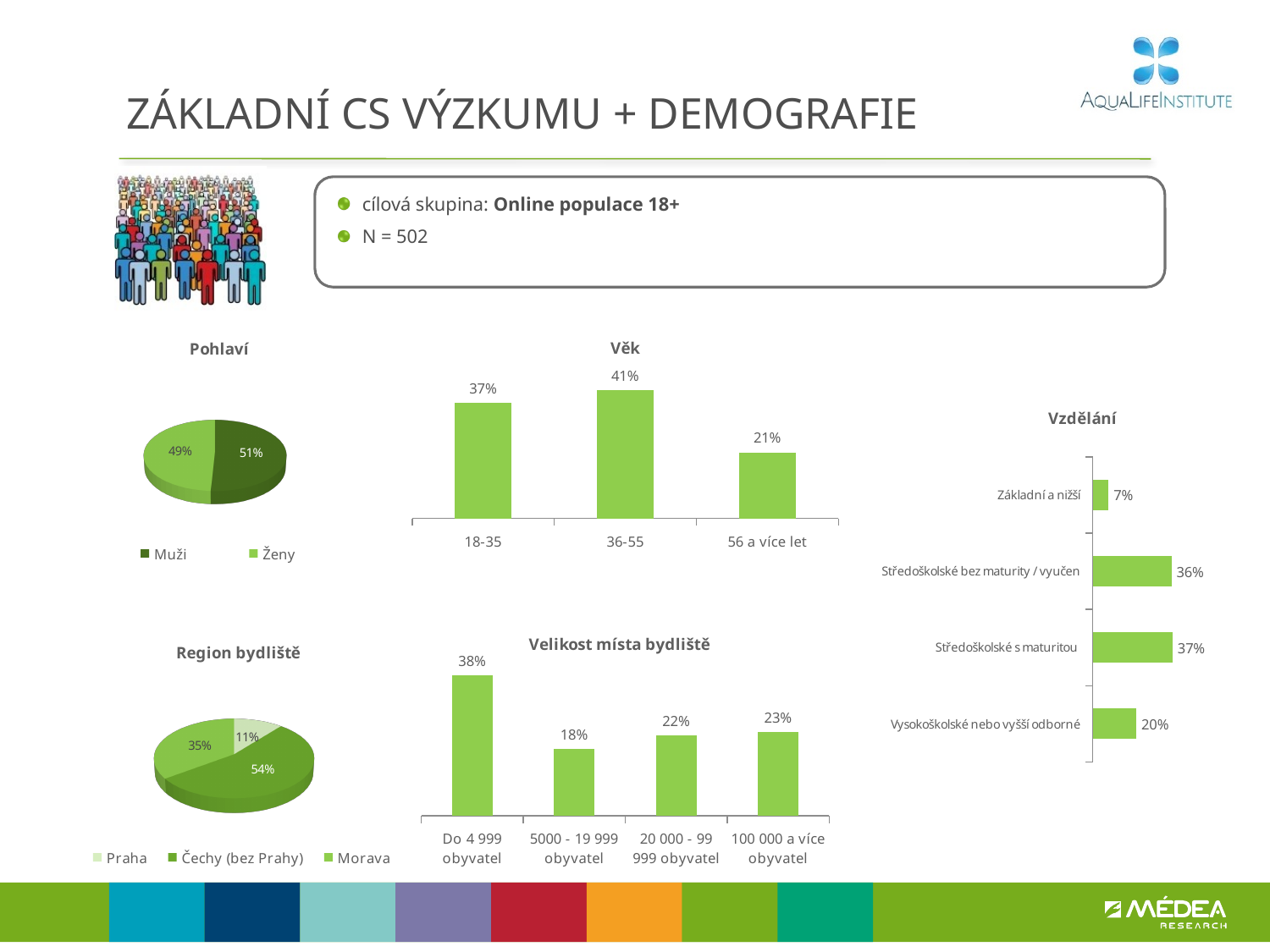
In the 'Věk' chart, what is the difference between the values for 18-35 and 56 a více let? 16 percentage points In the 'Region bydliště' chart, what share does 'Praha' have? 11% In the 'Vzdělání' chart, which category has the highest value? Středoškolské s maturitou In the 'Velikost místa bydliště' chart, what is the value for 'Do 4 999 obyvatel'? 38% In the 'Vzdělání' chart, what is the value for 'Vysokoškolské nebo vyšší odborné'? 20% In the 'Region bydliště' chart, which region has the largest share? Čechy (bez Prahy) What type of chart is the 'Pohlaví' chart? Pie chart In the 'Pohlaví' chart, what share does 'Muži' have? 51% In the 'Věk' chart, what is the value for the 36-55 age group? 41% How many categories are shown in the 'Vzdělání' chart? 4 In the 'Věk' chart, which age group has the lowest value? 56 a více let In the 'Velikost místa bydliště' chart, which is larger: the value for '5000 - 19 999 obyvatel' or '100 000 a více obyvatel'? 100 000 a více obyvatel